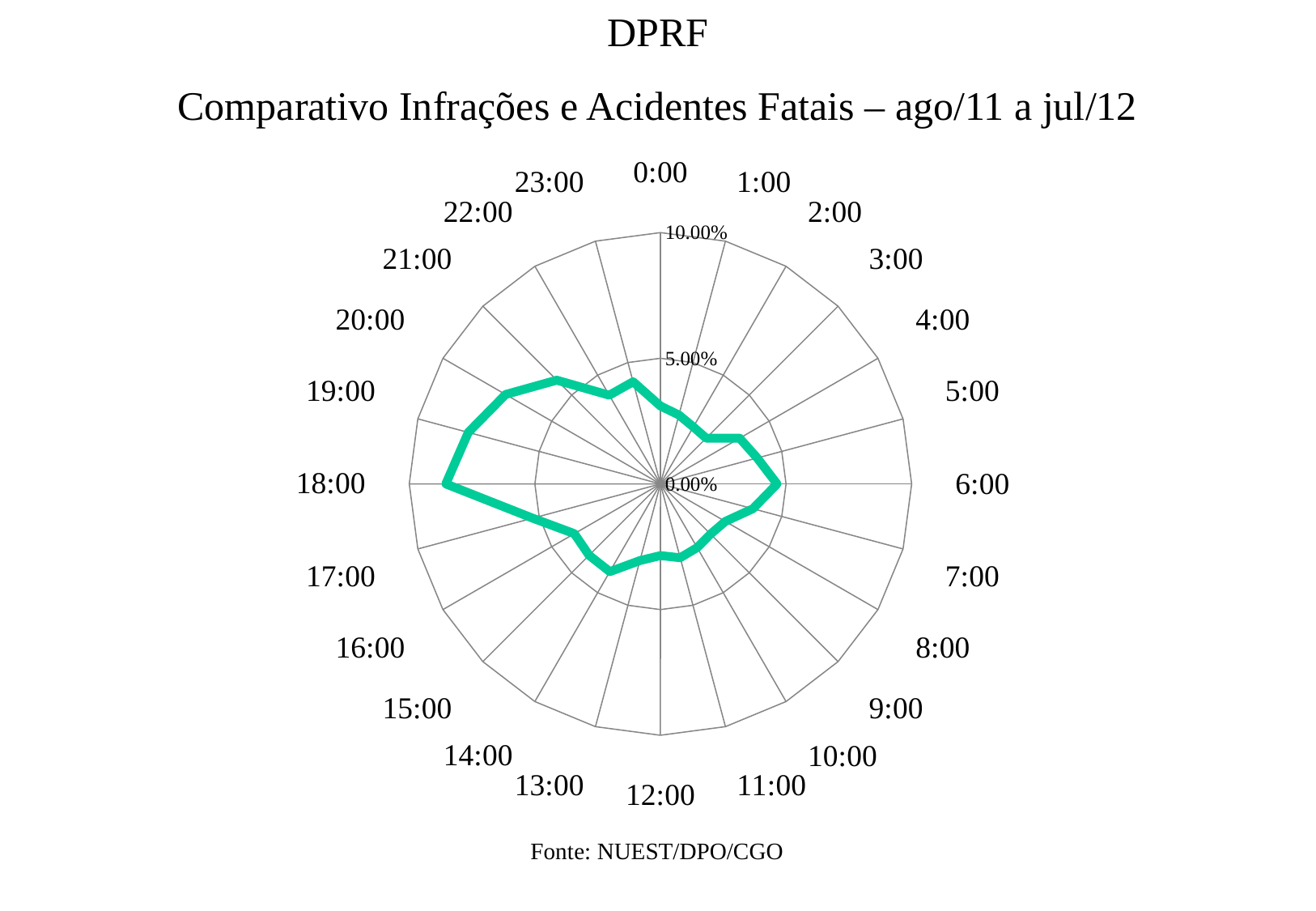
Is the value for 18:00 greater or less than 5.00%? greater Is the value for 0:00 greater or less than 5.00%? less What is the highest value labelled on the radial axis? 10.00% What source is cited below the chart? Fonte: NUEST/DPO/CGO Is the value for 19:00 greater or less than 5.00%? greater Which hour has the highest value on the chart? 18:00 Which is larger, the value for 18:00 or the value for 6:00? 18:00 How many hour categories are plotted around the chart? 24 Which is larger, the value for 19:00 or the value for 12:00? 19:00 What kind of chart is shown on the slide? Radar chart